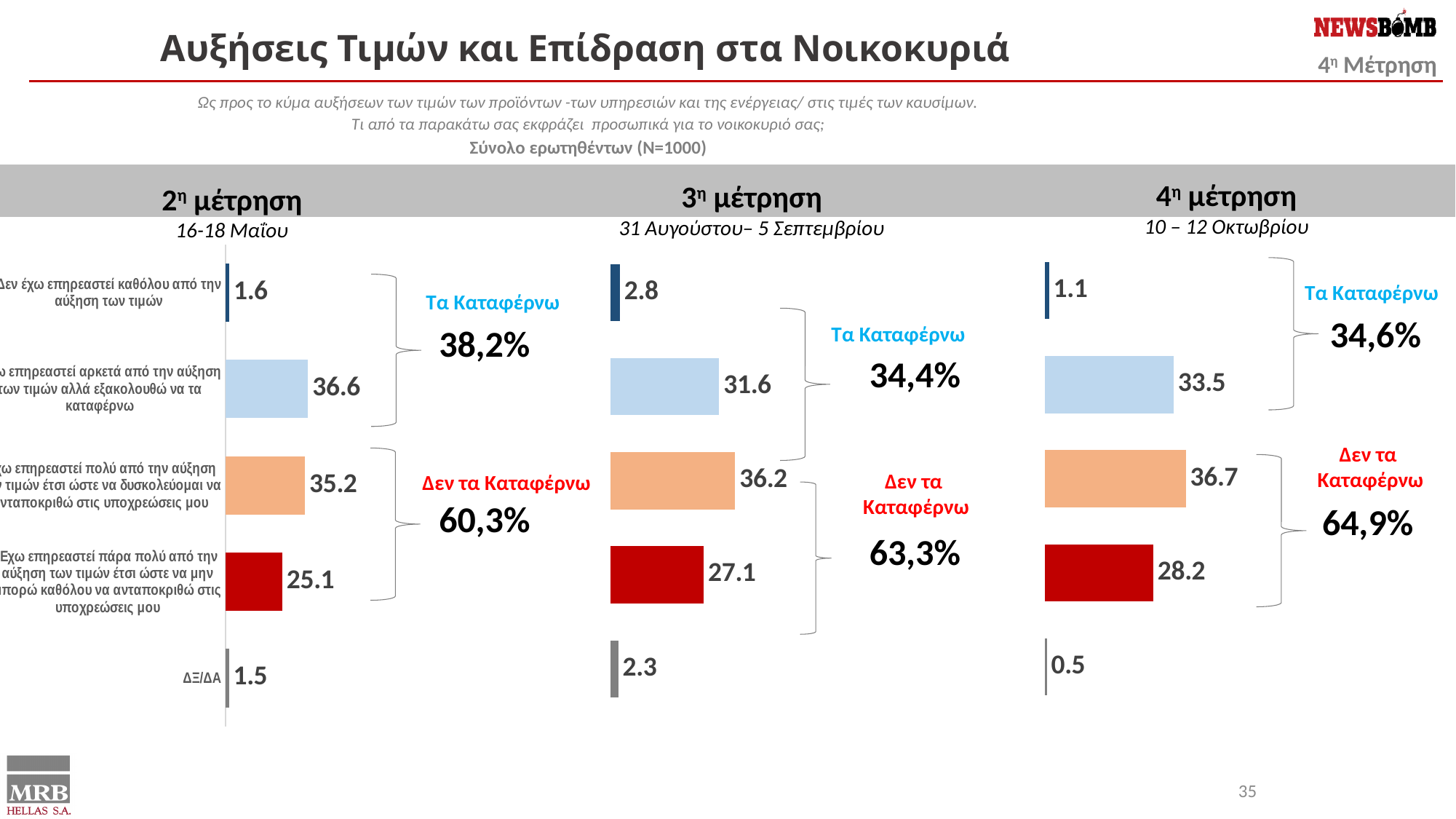
What is the 'Δεν τα Καταφέρνω' total shown for the 4η μέτρηση chart? 64,9% What date range is shown under the 4η μέτρηση chart heading? 10 – 12 Οκτωβρίου What is the 'Τα Καταφέρνω' total shown for the 3η μέτρηση chart? 34,4% In the 4η μέτρηση chart, what is the value for 'Δεν έχω επηρεαστεί καθόλου από την αύξηση των τιμών'? 1.1 In the 2η μέτρηση chart, what is the value for 'Έχω επηρεαστεί αρκετά από την αύξηση των τιμών αλλά εξακολουθώ να τα καταφέρνω'? 36.6 In the 4η μέτρηση chart, which category has the highest value? Έχω επηρεαστεί πολύ από την αύξηση των τιμών έτσι ώστε να δυσκολεύομαι να ανταποκριθώ στις υποχρεώσεις μου In the 2η μέτρηση chart, what is the difference between the values for 'Έχω επηρεαστεί πολύ...' (35.2) and 'Έχω επηρεαστεί πάρα πολύ...' (25.1)? 10.1 What kind of chart is used for the 2η μέτρηση data? Bar chart Which is larger: the ΔΞ/ΔΑ value in the 3η μέτρηση chart or the ΔΞ/ΔΑ value in the 4η μέτρηση chart? 3η μέτρηση (2.3) How many categories (bars) are shown in the 3η μέτρηση chart? 5 In the 4η μέτρηση chart, which category has the lowest value? ΔΞ/ΔΑ In the 3η μέτρηση chart, what is the value for 'Έχω επηρεαστεί πάρα πολύ από την αύξηση των τιμών έτσι ώστε να μην μπορώ καθόλου να ανταποκριθώ στις υποχρεώσεις μου'? 27.1